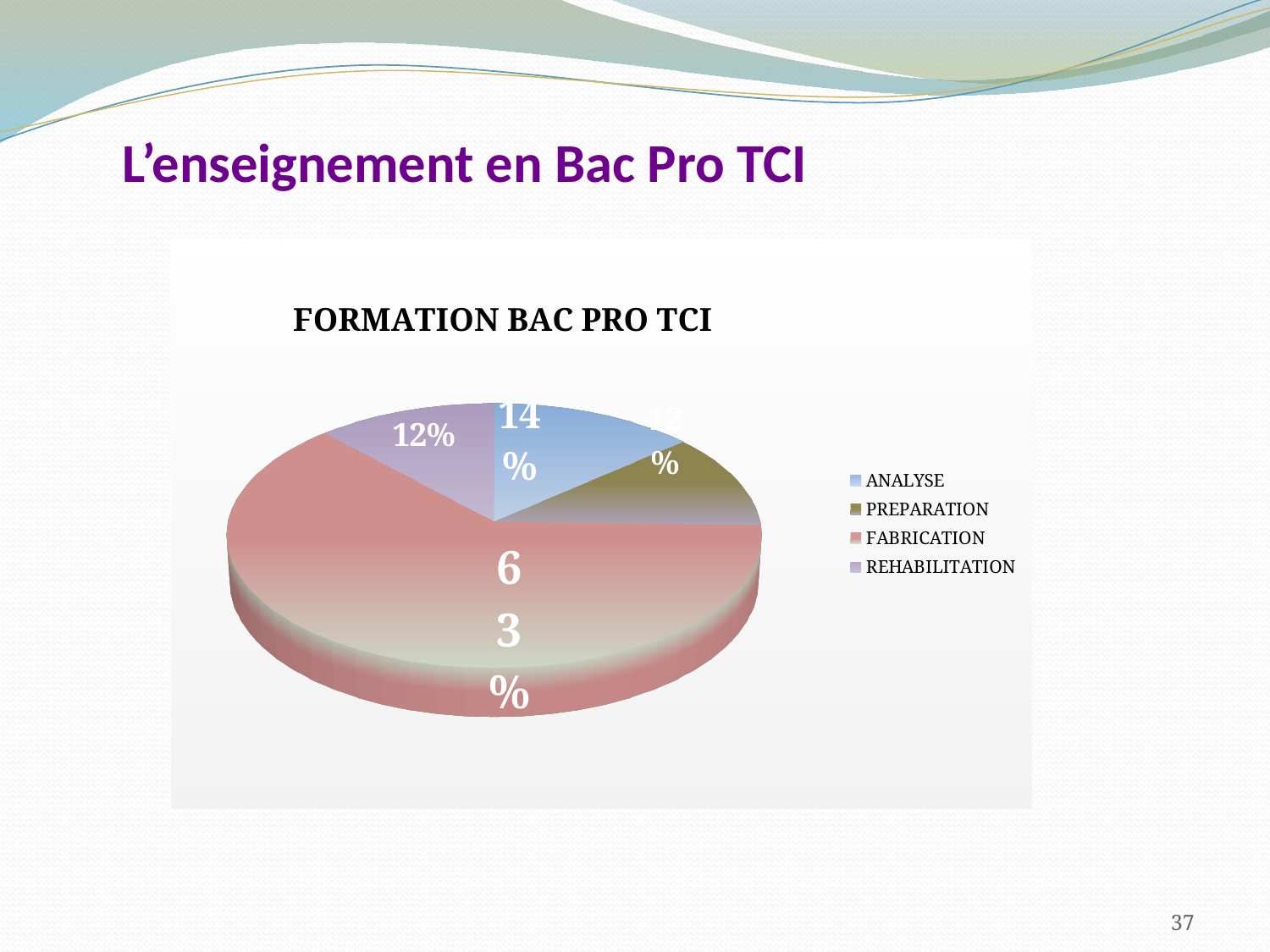
Is the share for FABRICATION greater or less than 50%? greater Which category has the largest slice of the pie? FABRICATION How many categories does the legend list? 4 What share of the pie does FABRICATION represent? 63% Which is larger, the ANALYSE slice or the REHABILITATION slice? ANALYSE What is the title of the chart? FORMATION BAC PRO TCI What is the difference between the FABRICATION share and the ANALYSE share? 49% What share of the pie does REHABILITATION represent? 12% What type of chart is shown on the slide? pie chart What is the difference between the ANALYSE share and the REHABILITATION share? 2% Which category is shown in red in the pie chart? FABRICATION What share of the pie does ANALYSE represent? 14%